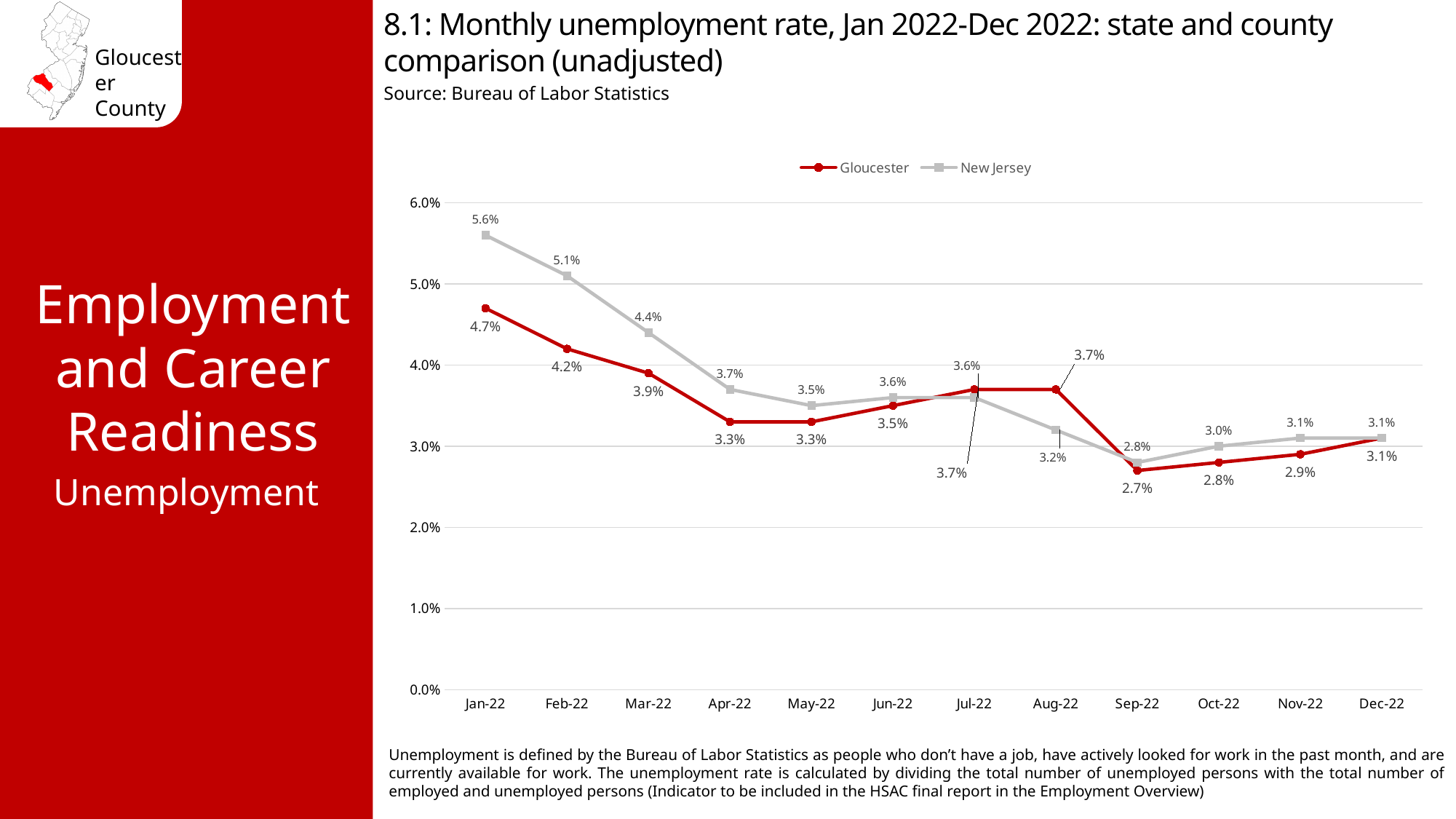
What is the difference between the New Jersey and Gloucester unemployment rates in Feb-22? 0.9% In which month was the New Jersey unemployment rate highest? Jan-22 What was the Gloucester unemployment rate in Sep-22? 2.7% What kind of chart is shown on the slide? Line chart What was the New Jersey unemployment rate in Mar-22? 4.4% In Aug-22, which had the higher unemployment rate, Gloucester or New Jersey? Gloucester How many series does the legend list? 2 What colour is the Gloucester line in the chart? Red Did the New Jersey unemployment rate rise or fall from Jan-22 to Apr-22? Fall In which month was the Gloucester unemployment rate lowest? Sep-22 How many months are plotted on the x axis? 12 What was the Gloucester unemployment rate in Jan-22? 4.7%